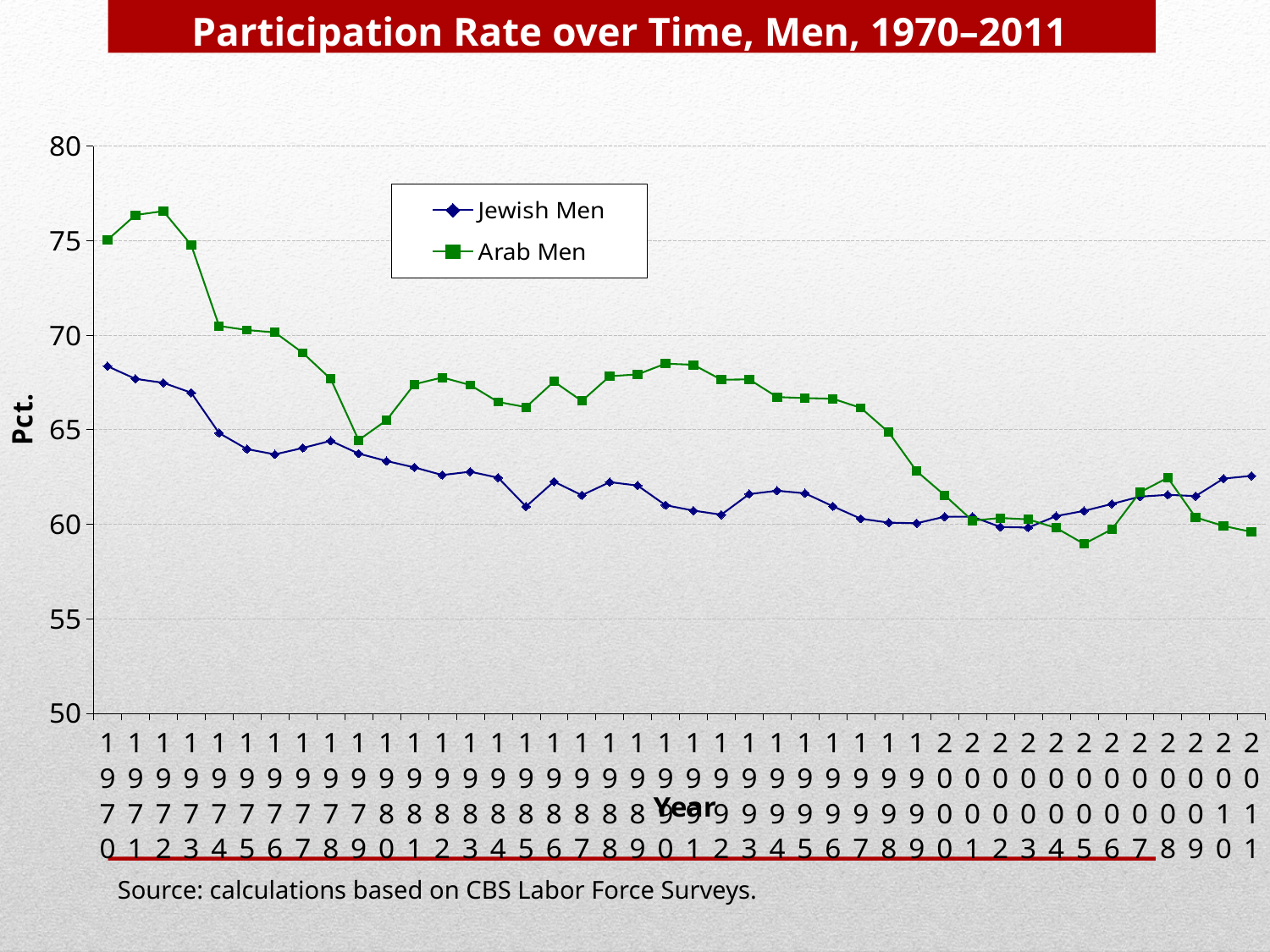
Which two series are listed in the legend? Jewish Men and Arab Men In 1970, which series has the higher participation rate, Jewish Men or Arab Men? Arab Men Is the value for Jewish Men in 2011 greater or less than 60? greater What is the title of the chart? Participation Rate over Time, Men, 1970–2011 How many years (data points per series) are plotted along the x axis? 42 Overall, does the participation rate for Arab Men rise or fall from 1970 to 2011? Fall What kind of chart is shown on the slide? Line chart Is the value for Arab Men in 1970 greater or less than 70? greater In 2011, which series has the higher participation rate, Jewish Men or Arab Men? Jewish Men How many series does the legend list? 2 Is the value for Jewish Men in 1970 greater or less than 70? less